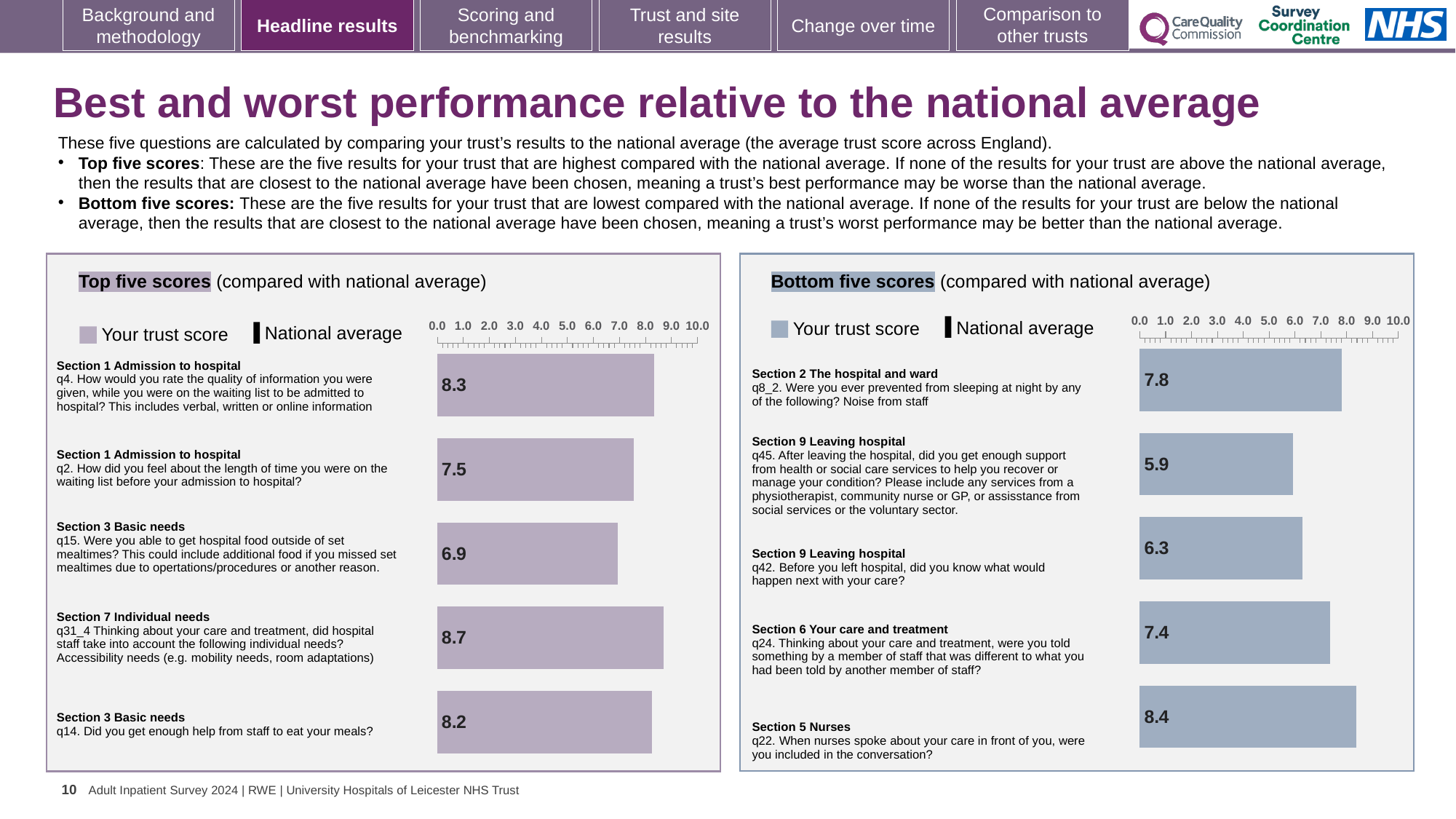
In the Bottom five scores chart, which question has the highest trust score? q22 (nurses including you in the conversation) In the Top five scores chart, which question has the highest trust score? q31_4 (Accessibility needs) In the Top five scores chart, what is the trust score for q4 (quality of information given while on the waiting list)? 8.3 In the Bottom five scores chart, what is the difference between the trust scores for q22 and q42? 2.1 In the Bottom five scores chart, which question has the lowest trust score? q45 (support after leaving hospital) How many entries does the legend of the Bottom five scores chart list? 2 In the Bottom five scores chart, what is the trust score for q45 (support from health or social care services after leaving hospital)? 5.9 In the Bottom five scores chart, is the trust score for q8_2 (noise from staff) or q24 (told something different by staff) larger? q8_2 In the Top five scores chart, what is the difference between the trust scores for q31_4 and q15? 1.8 In the Top five scores chart, how many bars are plotted? 5 What type of chart is used in the Top five scores panel? Bar chart In the Top five scores chart, which question has the lowest trust score? q15 (hospital food outside of set mealtimes)